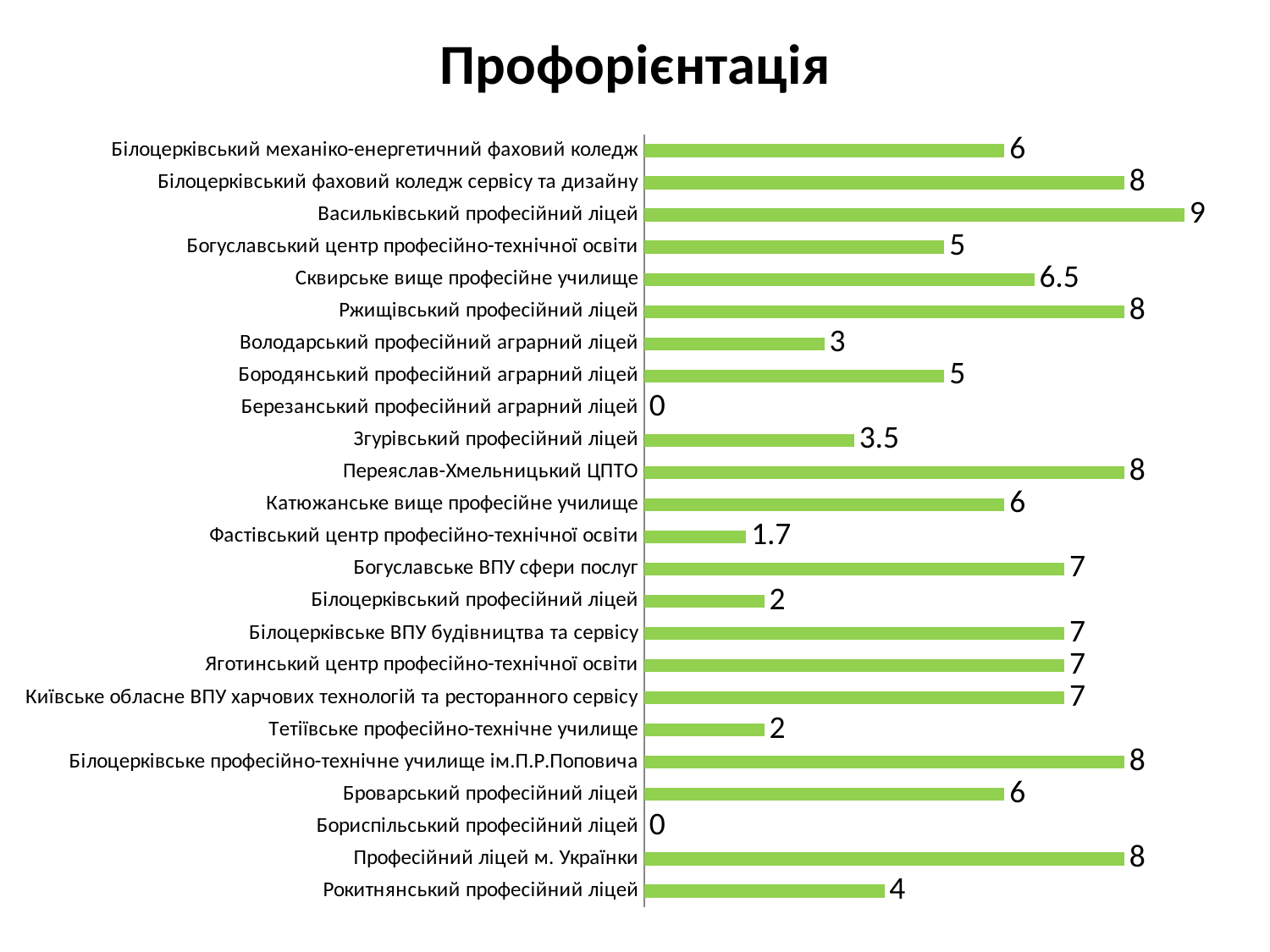
How many categories are shown in the chart? 24 What is the difference between the values for Васильківський професійний ліцей and Володарський професійний аграрний ліцей? 6 What is the difference between the values for Богуславське ВПУ сфери послуг and Білоцерківський професійний ліцей? 5 What kind of chart is shown on the slide? Bar chart What is the title of the chart? Профорієнтація What is the value for Васильківський професійний ліцей? 9 What is the value for Рокитнянський професійний ліцей? 4 What is the value for Сквирське вище професійне училище? 6.5 Which category has the highest value? Васильківський професійний ліцей Which is larger: the value for Ржищівський професійний ліцей or the value for Броварський професійний ліцей? Ржищівський професійний ліцей What is the value for Згурівський професійний ліцей? 3.5 What is the value for Фастівський центр професійно-технічної освіти? 1.7